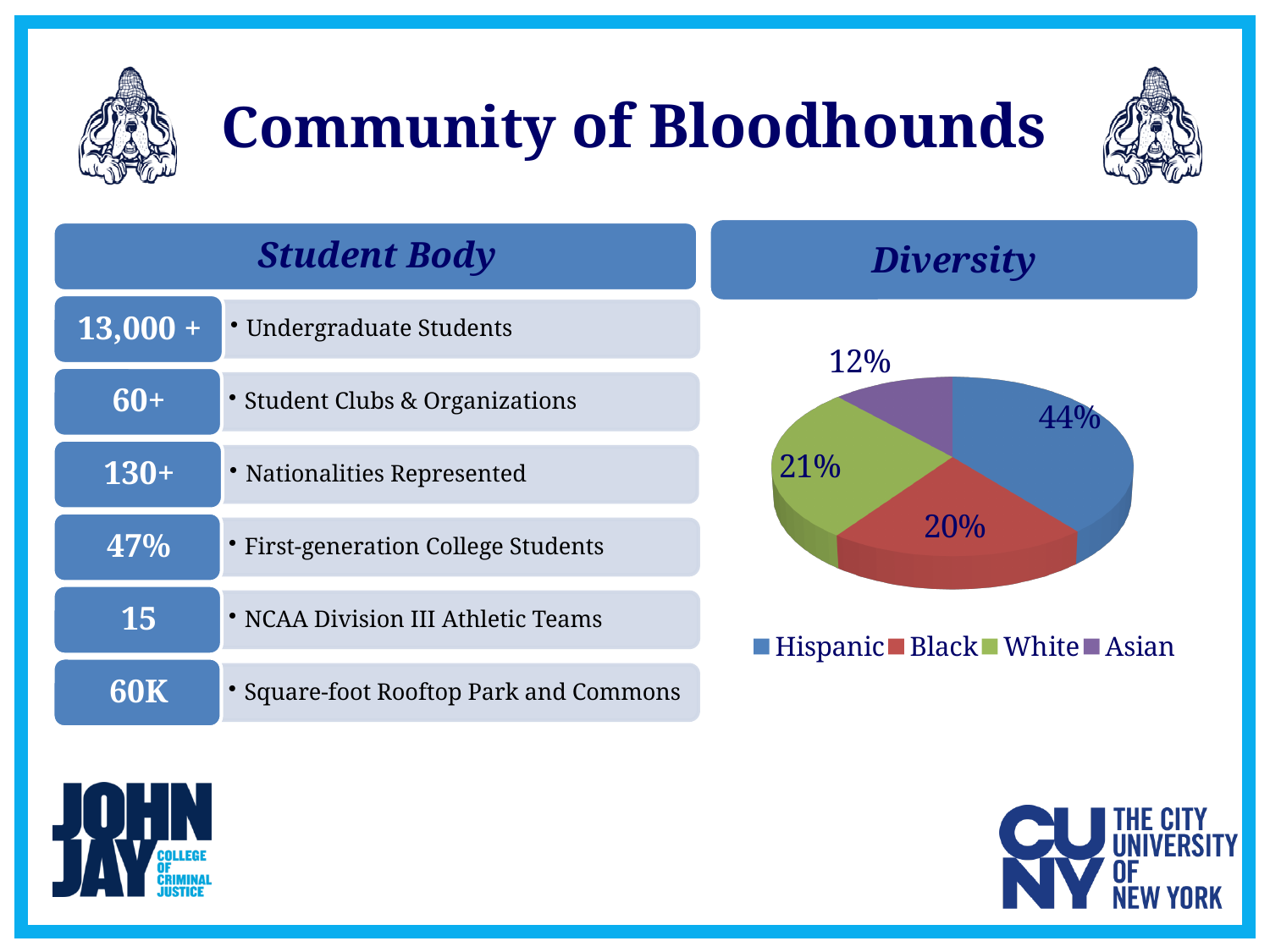
What kind of chart is used to show Diversity? Pie chart How many slices does the Diversity pie chart have? 4 Which is larger in the Diversity pie chart, the Hispanic share or the White share? Hispanic What percentage of the Diversity pie chart is Black? 20% Which colour represents Black in the Diversity pie chart? Red What is the title of the chart on the slide? Diversity Which group has the largest share in the Diversity pie chart? Hispanic What is the difference between the Hispanic and Asian shares in the Diversity pie chart? 32% Which group has the smallest share in the Diversity pie chart? Asian What percentage of the Diversity pie chart is White? 21% What percentage of the Diversity pie chart is Hispanic? 44% What percentage of the Diversity pie chart is Asian? 12%